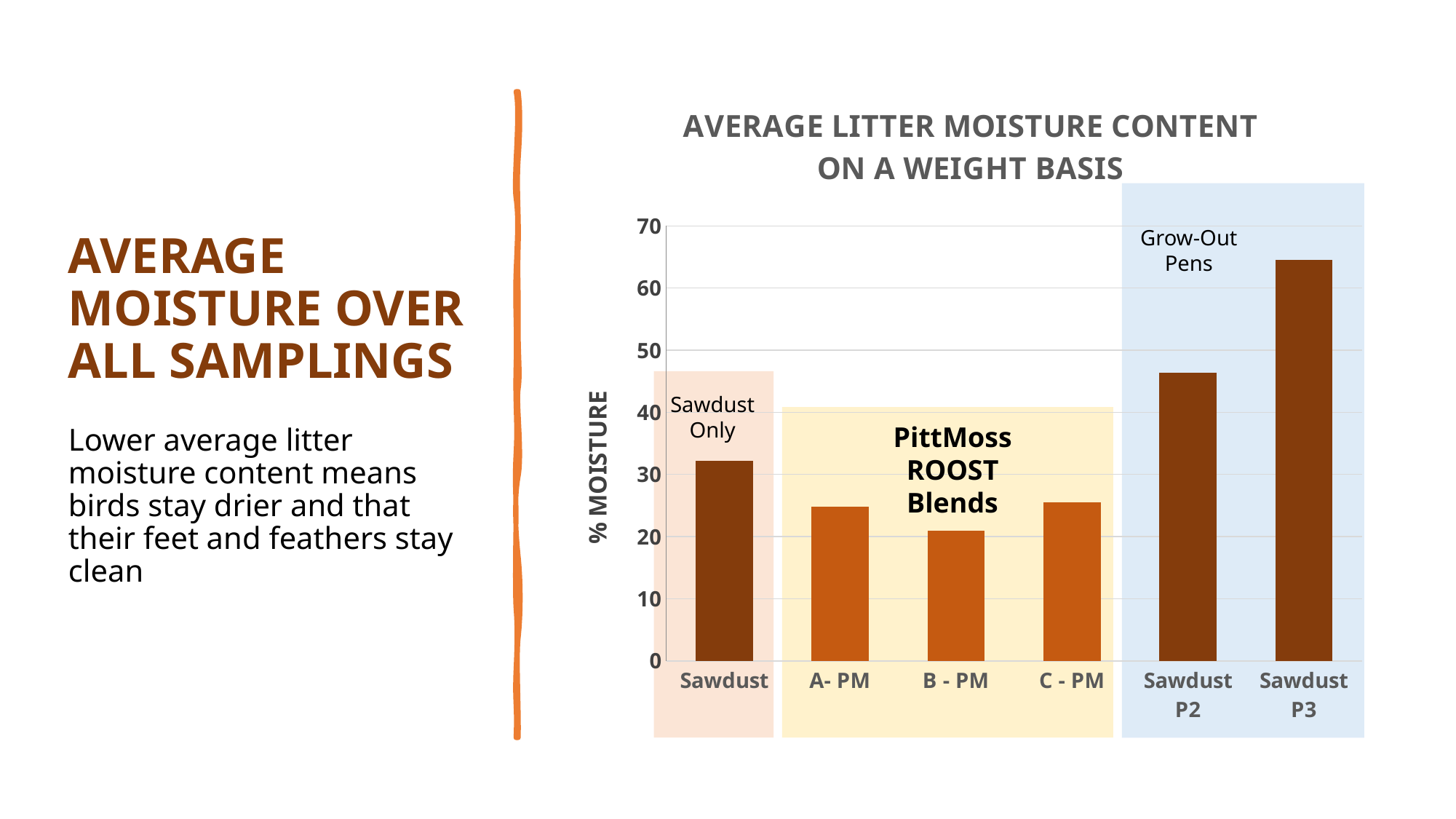
Is the value for Sawdust P3 greater or less than 60? greater How many bars (categories) are plotted in the chart? 6 Which has a higher % moisture, Sawdust P2 or Sawdust P3? Sawdust P3 Is the value for Sawdust greater or less than 30? greater Which has a higher % moisture, Sawdust or B - PM? Sawdust What is the label on the vertical axis of the chart? % MOISTURE Which category has the highest % moisture? Sawdust P3 Is the value for Sawdust P2 greater or less than 40? greater What kind of chart is shown on the slide? bar chart Which category has the lowest % moisture? B - PM What is the title of the chart? AVERAGE LITTER MOISTURE CONTENT ON A WEIGHT BASIS